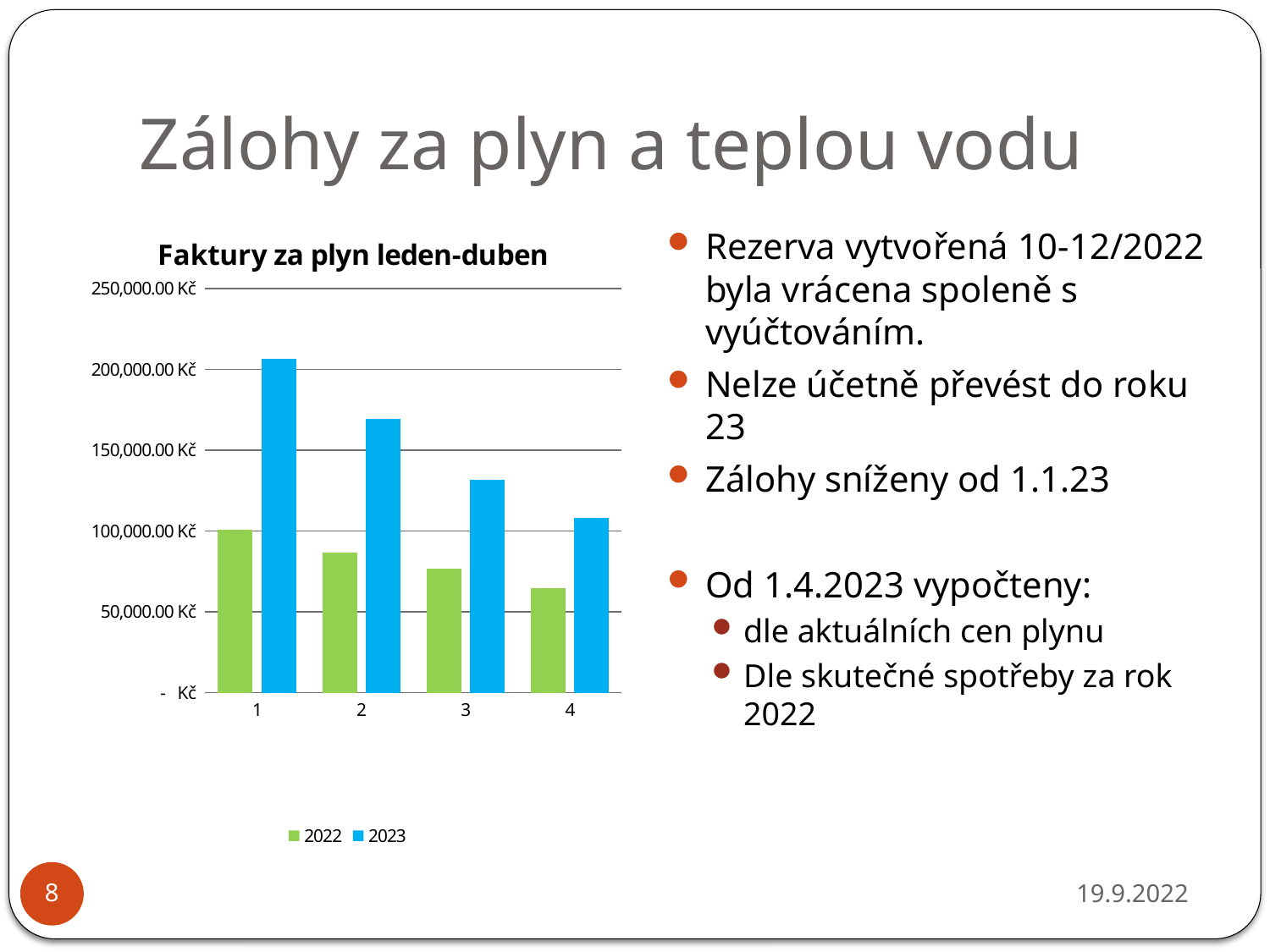
Do the 2023 values rise or fall from category 1 to category 4? fall How many series does the chart legend list? 2 Is the 2023 value for category 1 greater or less than 200,000.00 Kč? greater What is the title of the chart? Faktury za plyn leden-duben How many categories are shown on the x axis of the chart? 4 What kind of chart is shown on the slide? bar chart Which category has the highest value for the 2023 series? 1 Is the 2023 value for category 3 greater or less than 150,000.00 Kč? less Is the 2022 value for category 2 greater or less than 100,000.00 Kč? less For category 2, which series has the larger value, 2022 or 2023? 2023 Which category has the lowest value for the 2022 series? 4